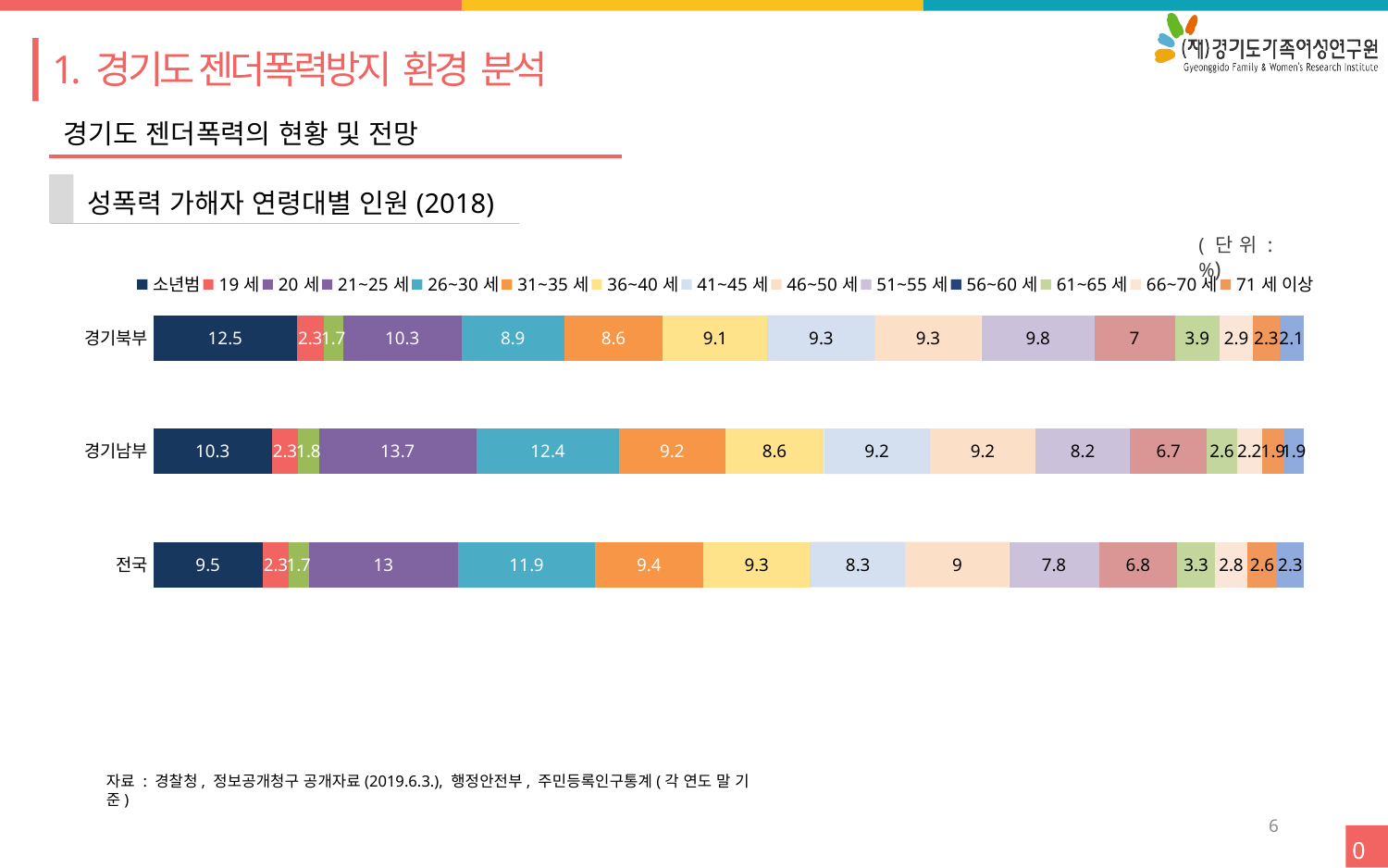
Which region has the highest 소년범 value? 경기북부 What is the 26~30세 value for 전국? 11.9 Which region has the lowest 56~60세 value? 경기남부 What is the 51~55세 value for 경기북부? 9.8 What is the 21~25세 value for 경기남부? 13.7 What is the 31~35세 value for 전국? 9.4 What is the difference between the 소년범 value for 경기북부 and for 전국? 3 What is the title of the chart? 성폭력 가해자 연령대별 인원 (2018) What is the 소년범 value for 경기북부? 12.5 Which is larger, the 21~25세 value for 경기남부 or for 전국? 경기남부 What kind of chart is shown on the slide? Stacked bar chart How many categories (regions) are plotted on the chart? 3